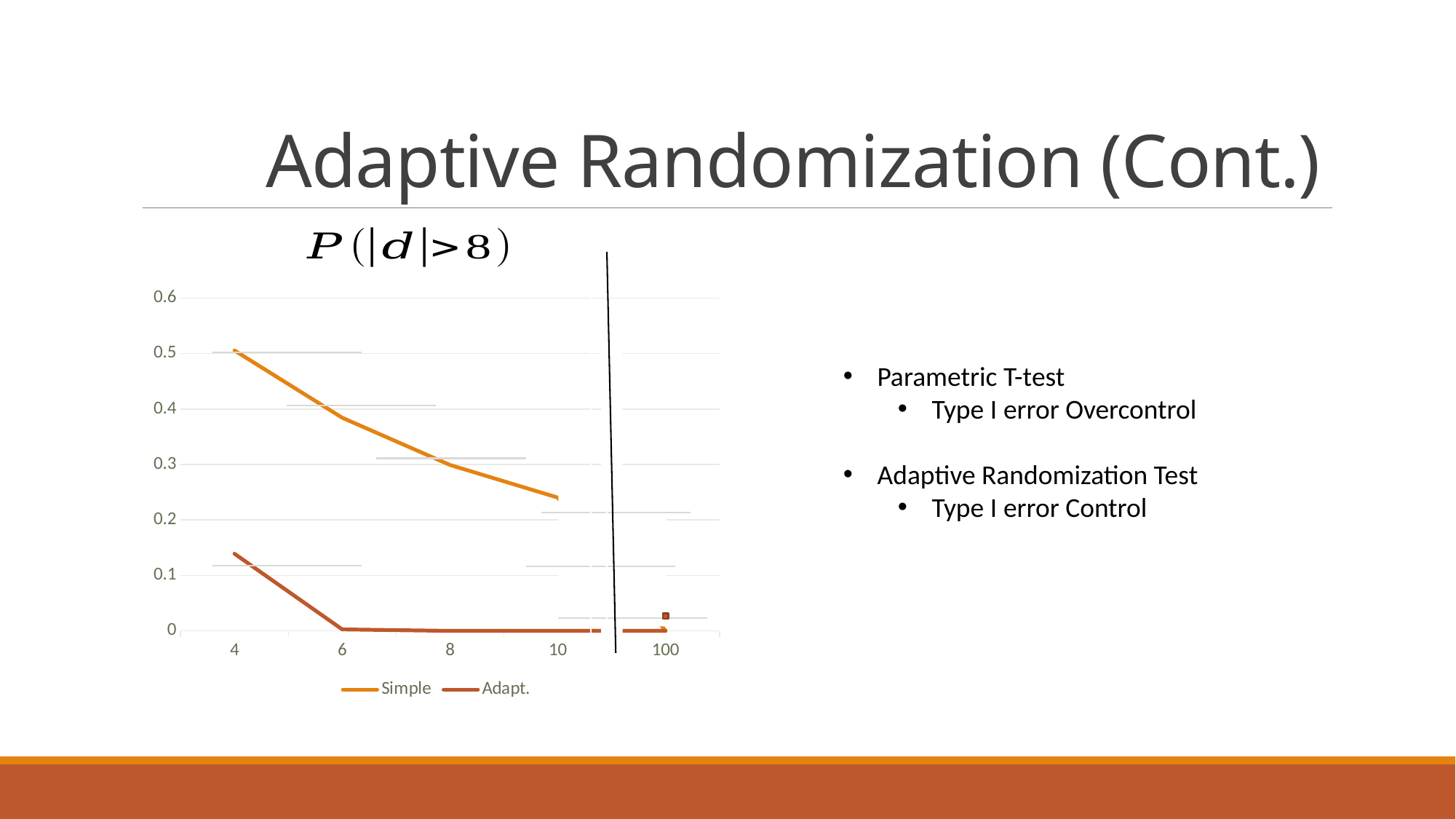
What are the names of the two series in the legend? Simple and Adapt. How many series does the legend list? 2 Is the value of the Simple series at x = 4 greater or less than 0.4? greater What kind of chart is shown on the slide? line chart Is the value of the Adapt. series at x = 8 greater or less than 0.1? less At x = 4, which series has the larger value, Simple or Adapt.? Simple Is the value of the Adapt. series at x = 4 greater or less than 0.1? greater Does the Simple series rise or fall as the x-axis goes from 4 to 10? fall At which x-axis value does the Simple series reach its highest value? 4 How many x-axis categories are shown on the chart? 5 What is the title of the chart? P(|d|>8)